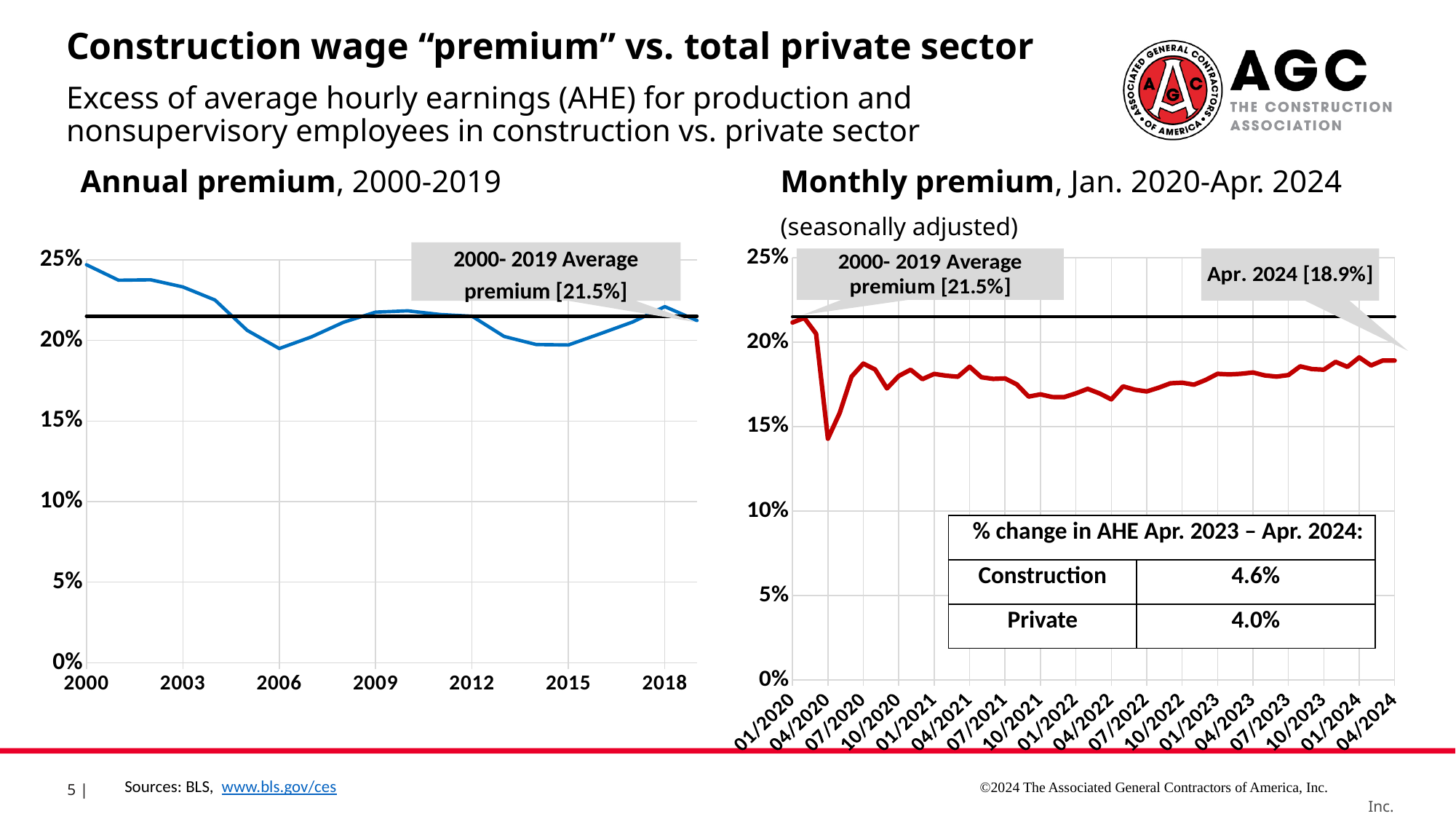
On the 'Monthly premium' chart, what is the premium value labeled for Apr. 2024? 18.9% What kind of chart is the 'Monthly premium, Jan. 2020-Apr. 2024' chart on the right? Line chart On the 'Annual premium' chart, is the value for 2006 greater or less than 20%? less On the 'Monthly premium' chart, is the value for 04/2020 greater or less than 15%? less On the 'Monthly premium' chart, how much lower is the Apr. 2024 premium (18.9%) than the 2000-2019 average premium (21.5%)? 2.6 percentage points On the 'Annual premium' chart, is the value for 2000 greater or less than 20%? greater On the 'Annual premium' chart, what value does the horizontal black line labeled '2000-2019 Average premium' represent? 21.5% On the 'Annual premium' chart, does the premium rise or fall from 2000 to 2006? fall What kind of chart is the 'Annual premium, 2000-2019' chart on the left? Line chart On the 'Annual premium' chart, which year has the highest premium? 2000 In the table on the 'Monthly premium' chart, what is the % change in AHE for Construction from Apr. 2023 to Apr. 2024? 4.6% On the 'Monthly premium' chart, which is larger: the Apr. 2024 premium or the 2000-2019 average premium? 2000-2019 average premium